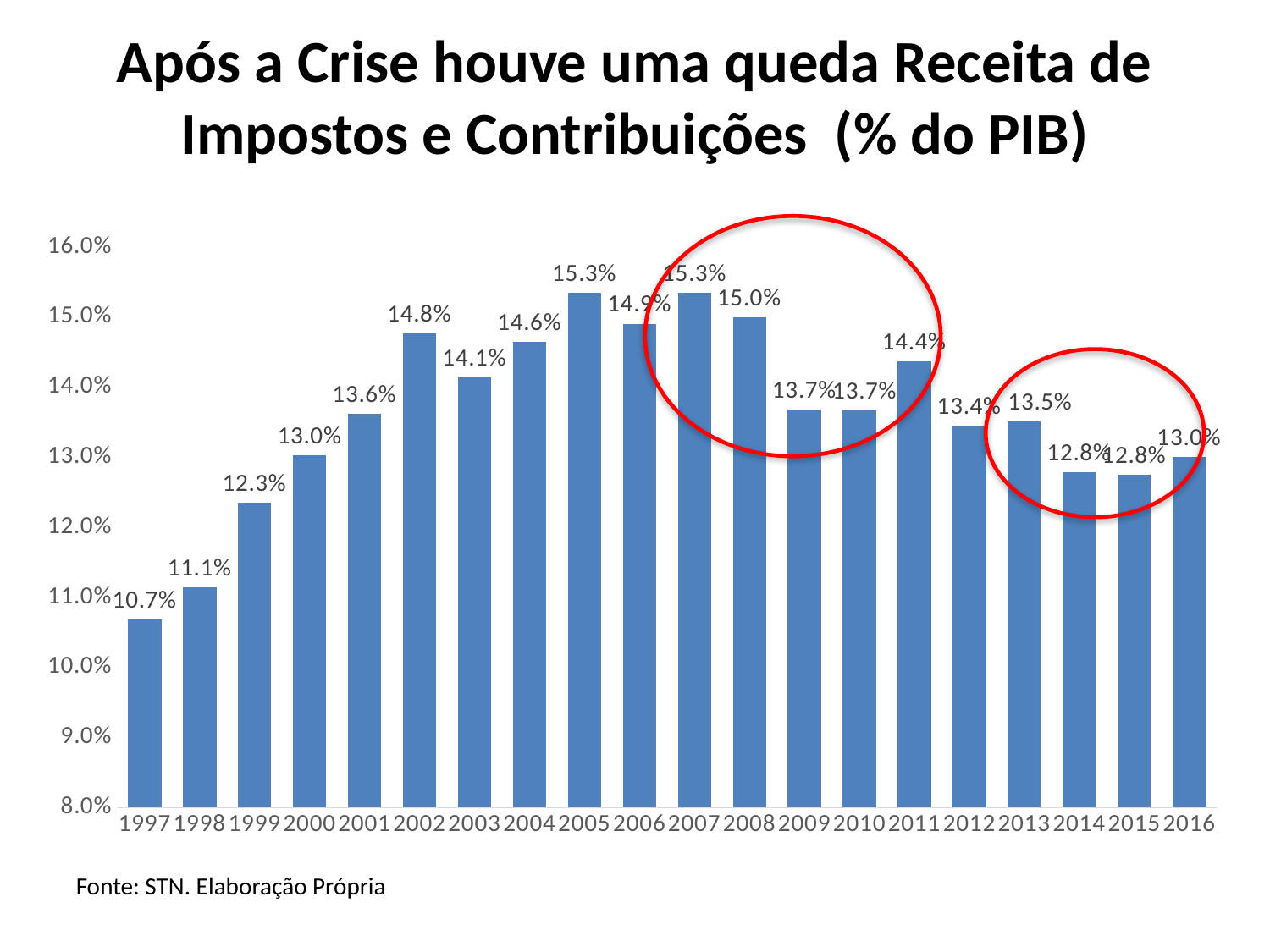
What is the value for 1999? 12.3% What is the highest value shown on the chart? 15.3% Do the values rise or fall from 2013 to 2014? Fall What kind of chart is shown on the slide? Bar chart What is the value for 2008? 15.0% What is the value for 2016? 13.0% Which year has the lowest value? 1997 Which is larger, the value for 2002 or the value for 2004? 2002 Is the value for 2011 greater or less than 14.0%? greater What source is cited below the chart? STN. Elaboração Própria What is the difference between the values for 2007 and 2009? 1.6% How many years are shown on the x axis? 20